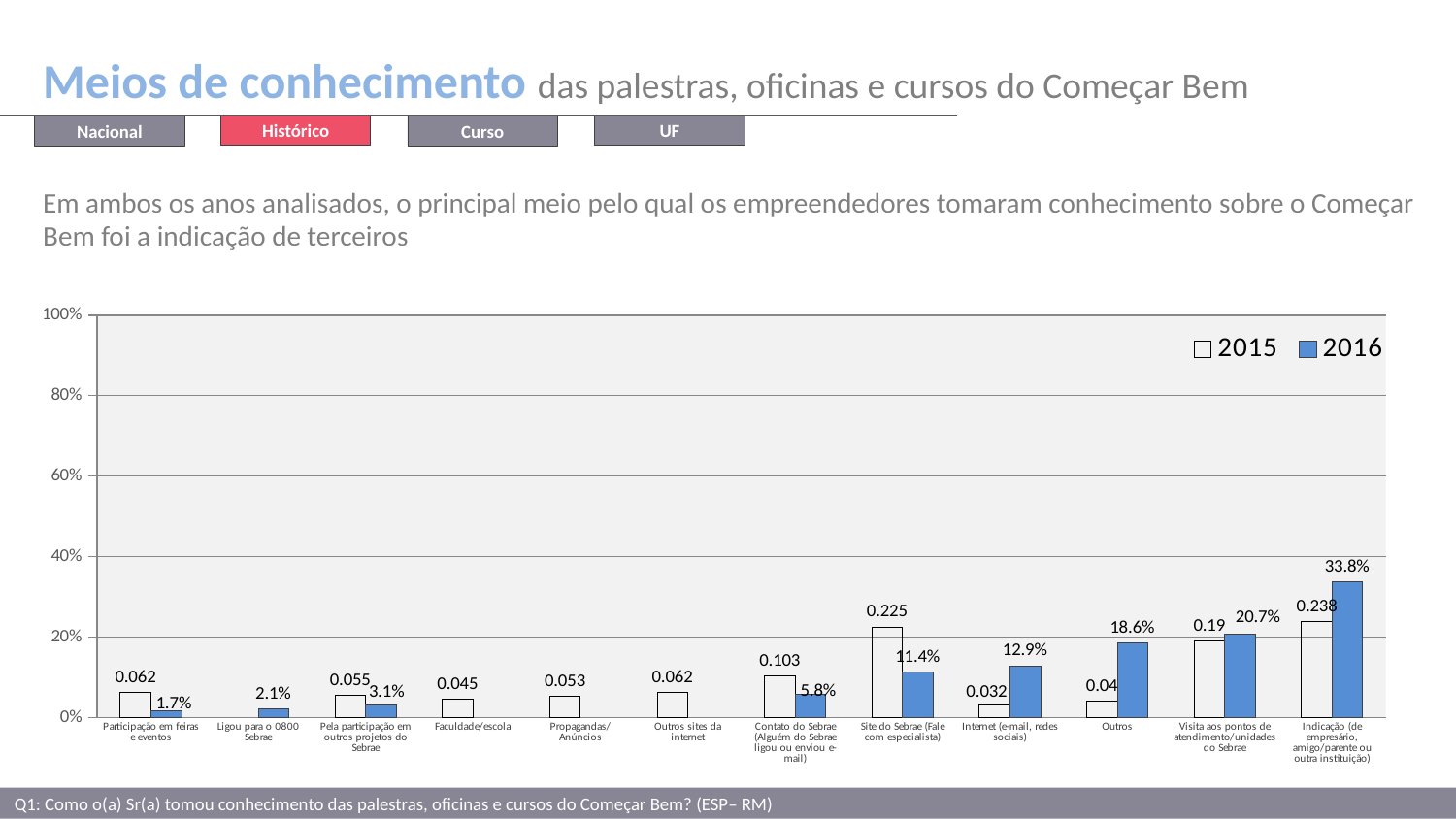
Is the 2016 value for 'Indicação' greater or less than 40%? less What is the difference between the 2016 values for 'Indicação' and 'Visita aos pontos de atendimento/unidades do Sebrae'? 13.1 percentage points What kind of chart is shown on the slide? Bar chart Which has the larger 2016 value: 'Outros' or 'Internet (e-mail, redes sociais)'? Outros How many series does the legend list? 2 How many categories are shown on the x axis? 12 Which category has the lowest labelled 2016 value? Participação em feiras e eventos Which category has the highest 2016 value? Indicação (de empresário, amigo/parente ou outra instituição) What is the 2015 value labelled for 'Visita aos pontos de atendimento/unidades do Sebrae'? 0.19 What is the 2015 value labelled for 'Site do Sebrae (Fale com especialista)'? 0.225 What is the 2016 value for 'Indicação (de empresário, amigo/parente ou outra instituição)'? 33.8% What is the 2016 value for 'Internet (e-mail, redes sociais)'? 12.9%